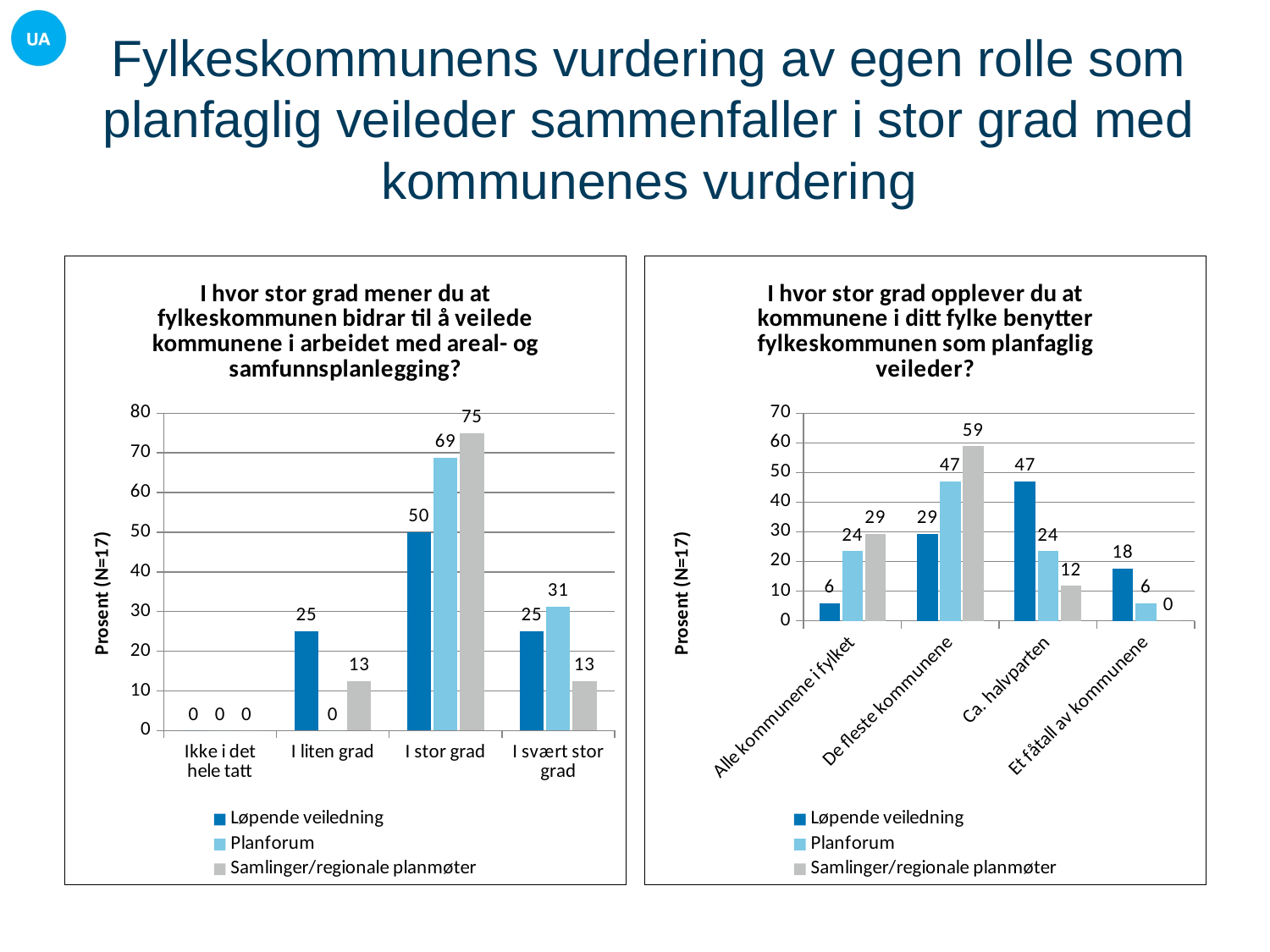
In the right chart, which category has the highest value for Løpende veiledning? Ca. halvparten What is the y-axis label of the left chart? Prosent (N=17) In the left chart, which is larger in the 'I svært stor grad' category: Planforum or Samlinger/regionale planmøter? Planforum In the right chart, what is the value for Planforum in the 'De fleste kommunene' category? 47 In the left chart, what is the value for Samlinger/regionale planmøter in the 'I stor grad' category? 75 In the right chart, which category has the lowest value for Samlinger/regionale planmøter? Et fåtall av kommunene In the left chart, what is the value for Løpende veiledning in the 'I liten grad' category? 25 In the right chart, what is the difference between the Samlinger/regionale planmøter and Løpende veiledning values in the 'De fleste kommunene' category? 30 In the left chart, what is the difference between the Planforum and Løpende veiledning values in the 'I stor grad' category? 19 How many series does the legend of the left chart list? 3 What type of chart is the right chart? Bar chart How many categories are shown on the x axis of the right chart? 4